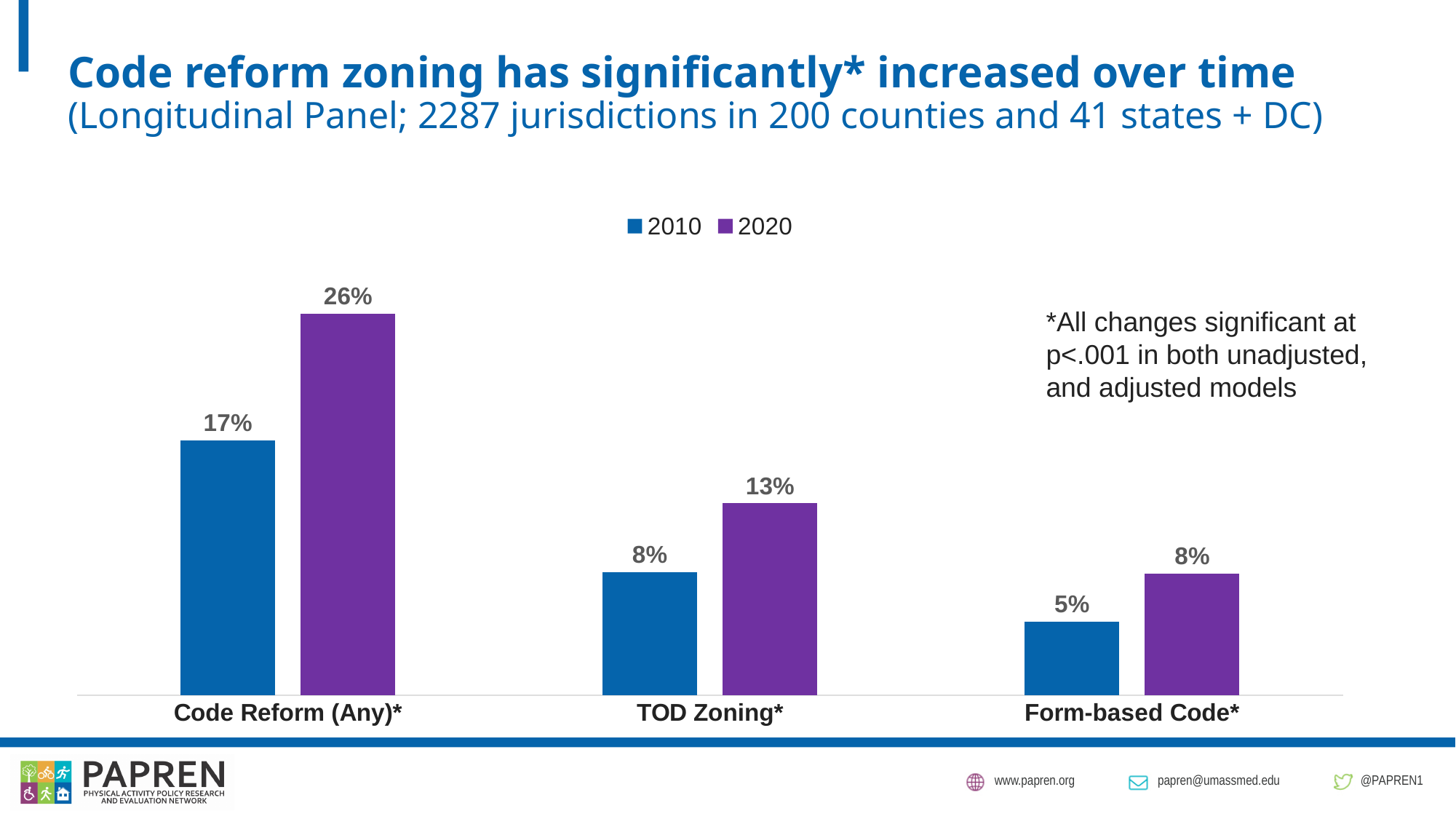
How many series does the legend list? 2 Which category has the lowest 2010 value? Form-based Code* What was the value for Form-based Code* in 2010? 5% Which category has the highest 2020 value? Code Reform (Any)* What is the difference between the 2020 and 2010 values for TOD Zoning*? 5% Which is larger: the 2010 value for TOD Zoning* or the 2020 value for Form-based Code*? They are equal (8%) What was the value for Code Reform (Any)* in 2010? 17% What was the value for TOD Zoning* in 2020? 13% What is the difference between the 2020 and 2010 values for Code Reform (Any)*? 9% What kind of chart is shown on the slide? Bar chart What was the value for Code Reform (Any)* in 2020? 26% How many categories are shown on the x axis? 3